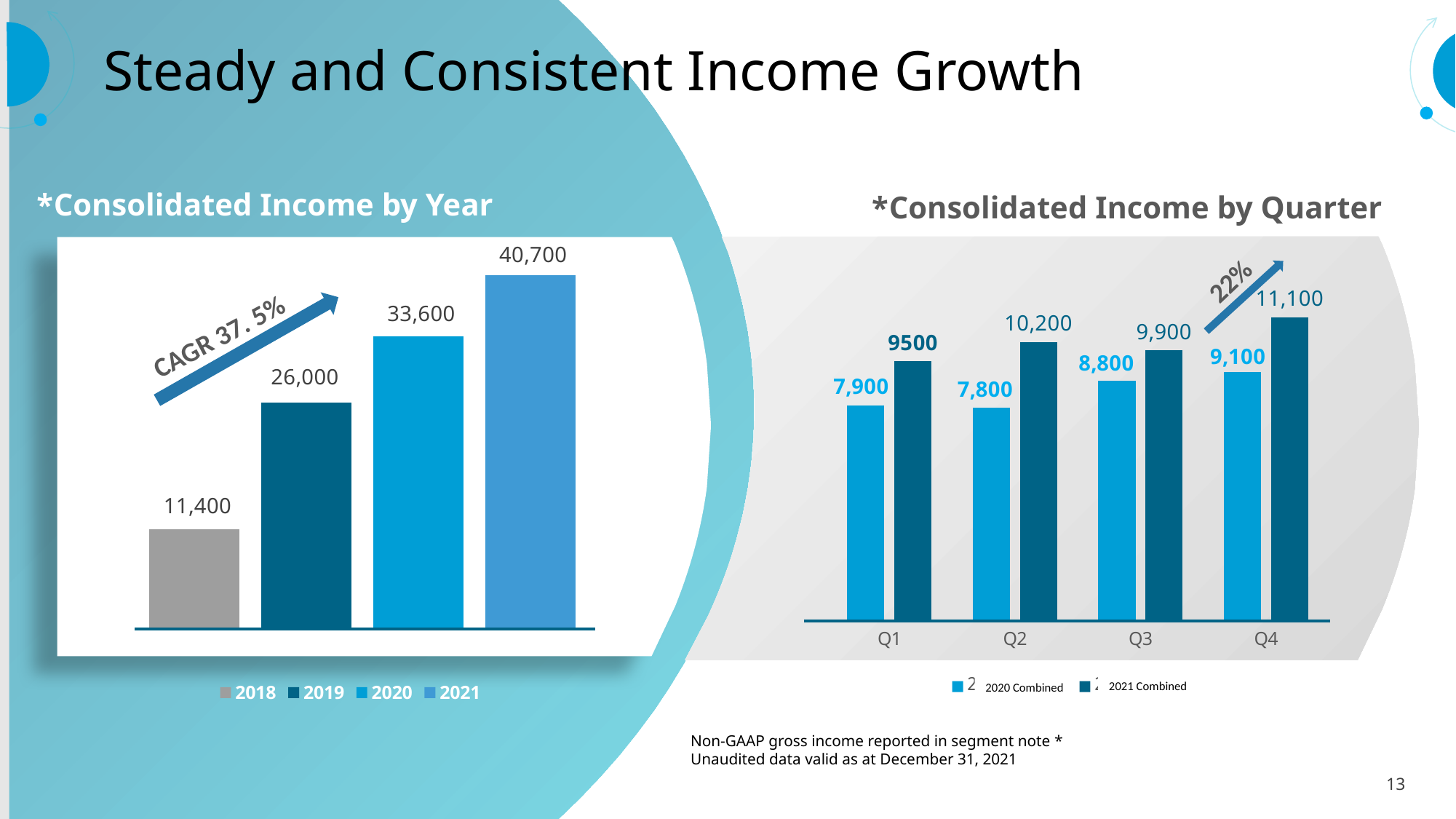
What kind of chart is the Consolidated Income by Quarter chart? bar chart In the Consolidated Income by Year chart, what is the value for 2018? 11,400 In the Consolidated Income by Year chart, what is the value for 2021? 40,700 In the Consolidated Income by Quarter chart, what is the 2020 Combined value for Q3? 8,800 In the Consolidated Income by Year chart, how many years are shown? 4 In the Consolidated Income by Quarter chart, how many series does the legend list? 2 In the Consolidated Income by Year chart, which year has the lowest income? 2018 In the Consolidated Income by Year chart, what is the difference between the 2020 and 2019 values? 7,600 In the Consolidated Income by Quarter chart, what is the difference between the 2021 Combined and 2020 Combined values for Q4? 2,000 In the Consolidated Income by Quarter chart, which quarter has the highest 2021 Combined value? Q4 In the Consolidated Income by Year chart, do the values rise or fall from 2018 to 2021? rise In the Consolidated Income by Quarter chart, what is the 2021 Combined value for Q2? 10,200